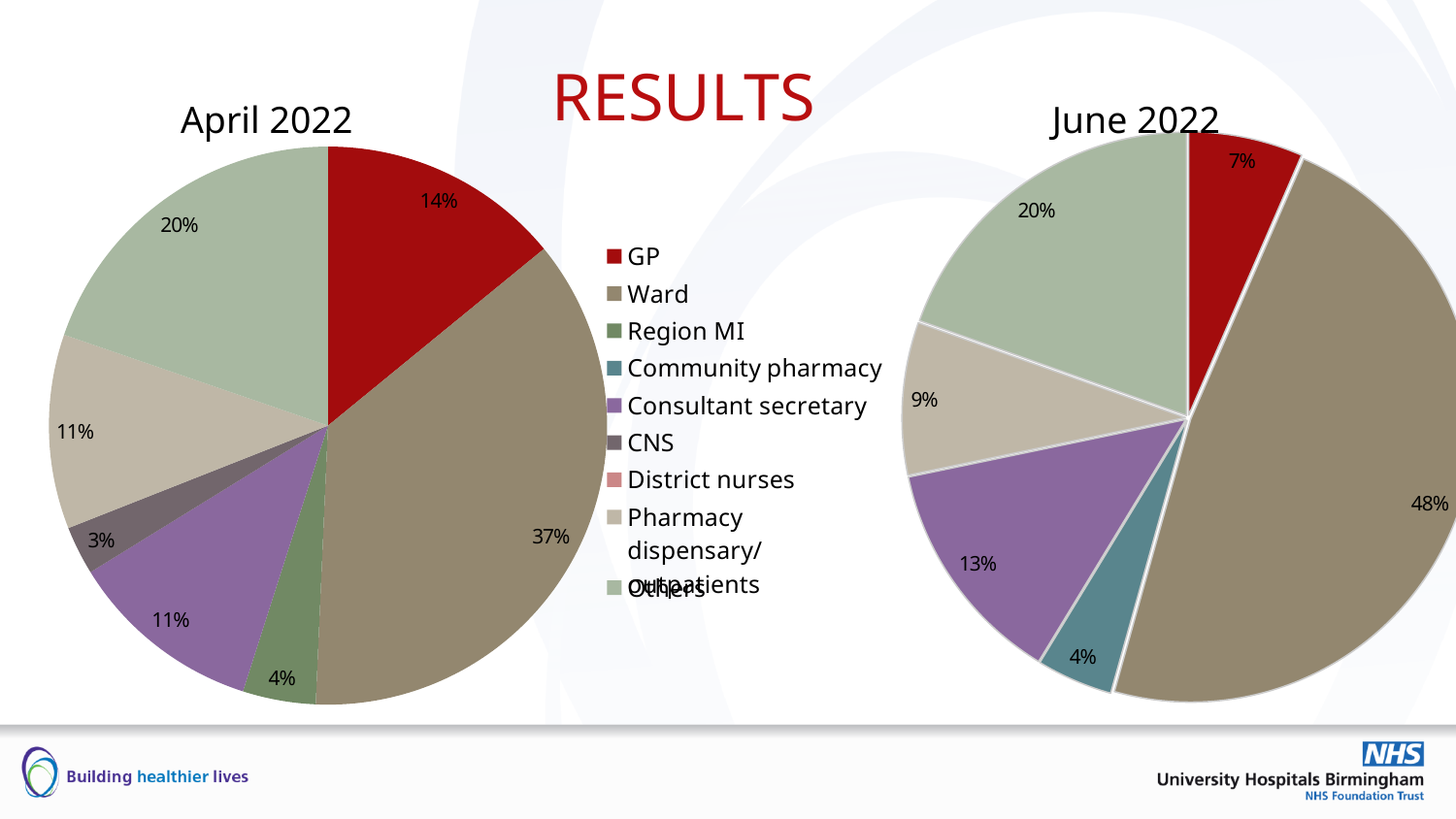
What type of chart is used for April 2022 and June 2022? Pie chart In the April 2022 pie chart, which labelled category has the smallest slice? CNS How many categories does the shared legend list? 9 What is the difference between the Ward share in June 2022 and the Ward share in April 2022? 11% Which is larger: the GP share in April 2022 or the GP share in June 2022? April 2022 In the April 2022 pie chart, what percentage is shown for Others? 20% In the June 2022 pie chart, what percentage is shown for Consultant secretary? 13% What colour represents GP in the legend? Red In the June 2022 pie chart, which category has the largest slice? Ward In the June 2022 pie chart, what percentage is shown for GP? 7% In the June 2022 pie chart, what percentage is shown for Community pharmacy? 4% In the April 2022 pie chart, what percentage is shown for Ward? 37%